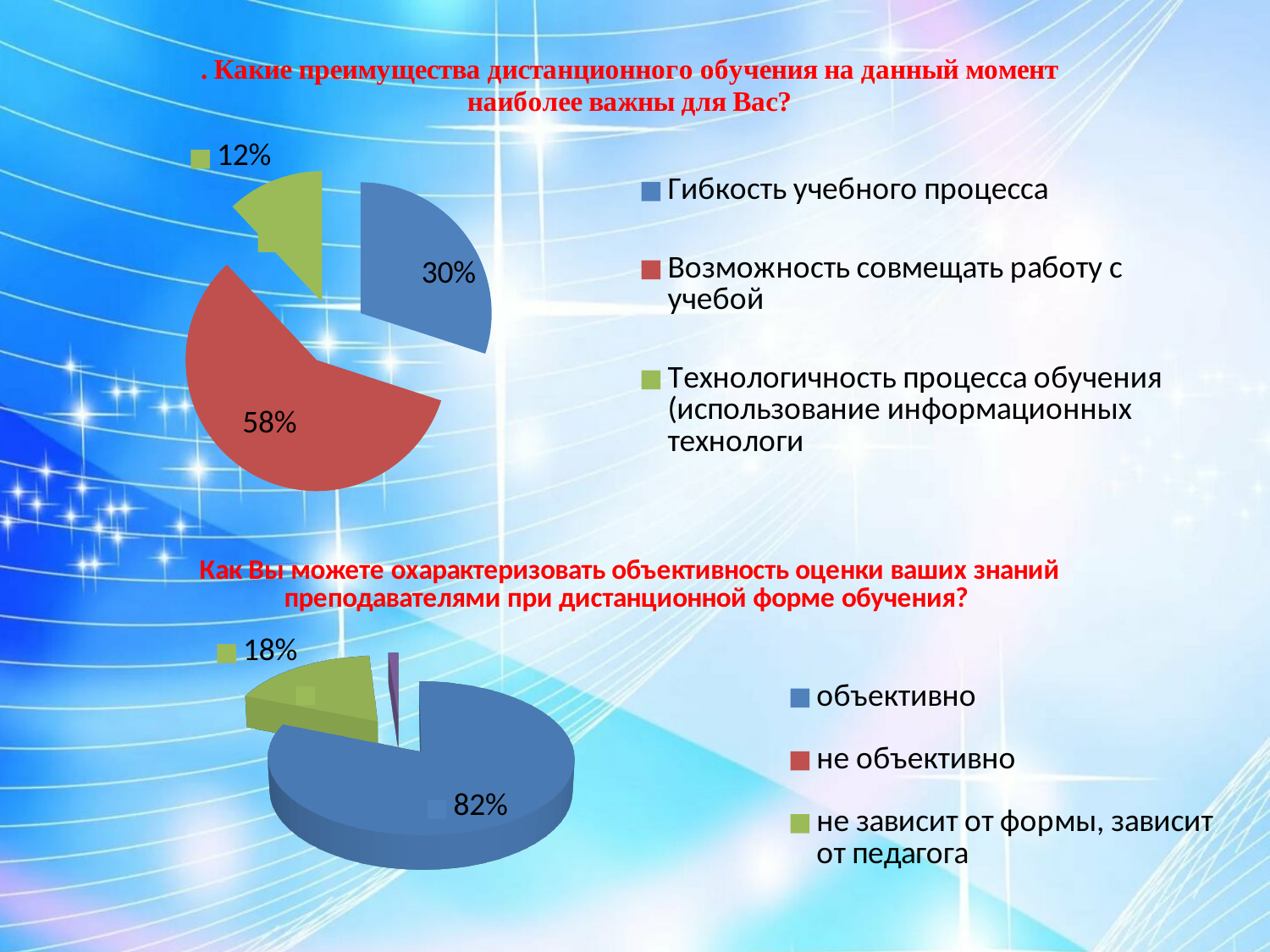
On the bottom chart, which category has the largest slice? объективно On the top chart ("Какие преимущества дистанционного обучения..."), what share is shown for "Гибкость учебного процесса"? 30% On the bottom chart, what share is shown for "объективно"? 82% On the top chart, which category has the largest slice? Возможность совмещать работу с учебой On the bottom chart, what share is shown for "не зависит от формы, зависит от педагога"? 18% On the top chart, which category has the smallest slice? Технологичность процесса обучения What kind of chart is the bottom chart ("Как Вы можете охарактеризовать объективность оценки...")? Pie chart On the top chart, what is the difference between the shares for "Возможность совмещать работу с учебой" and "Гибкость учебного процесса"? 28% On the top chart, how many categories does the legend list? 3 On the top chart, what share is shown for "Технологичность процесса обучения"? 12% On the top chart, what share is shown for "Возможность совмещать работу с учебой"? 58% On the bottom chart, which colour represents "не объективно" in the legend? Red